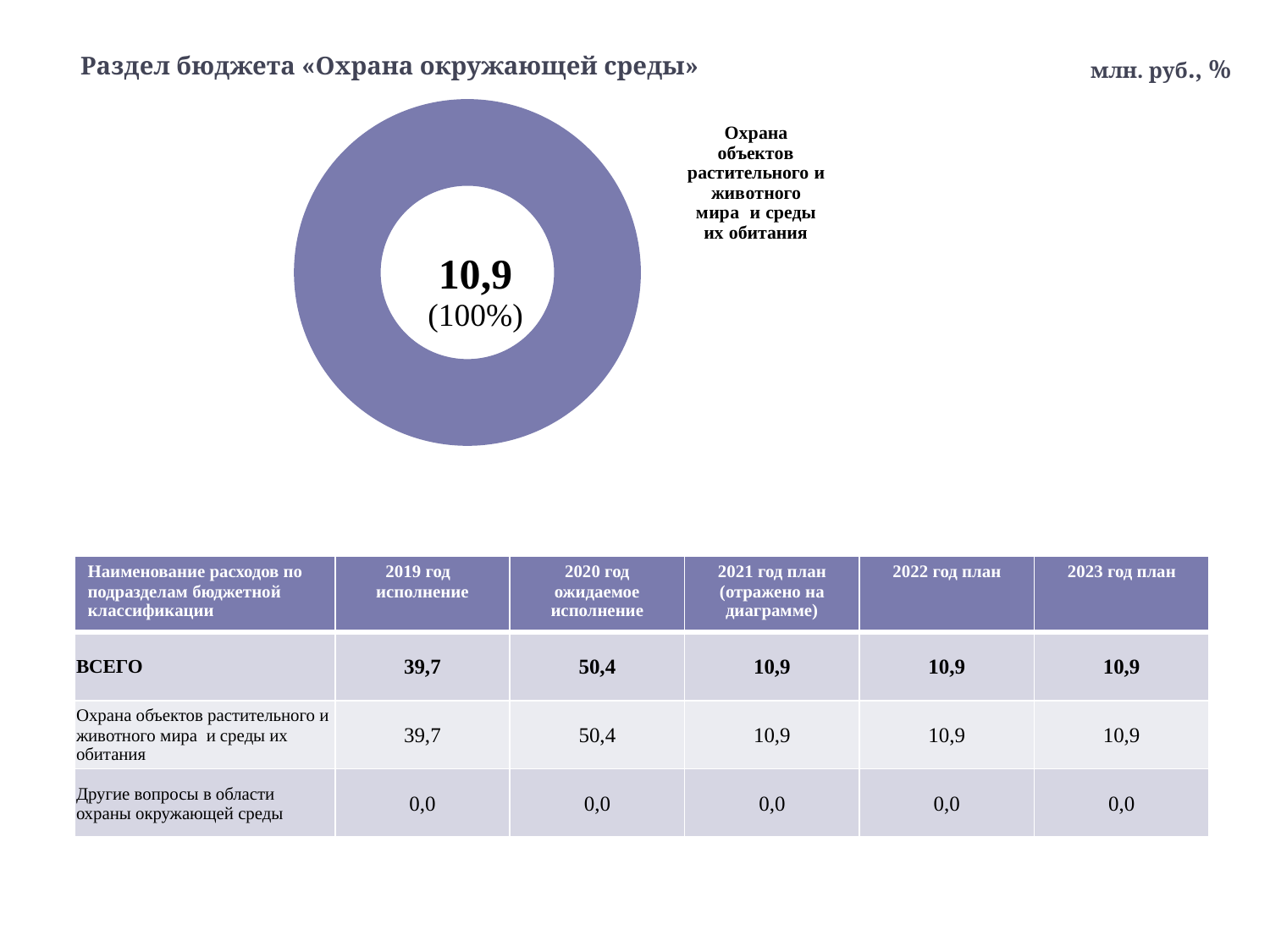
What value is printed in the centre of the donut chart? 10,9 Which year's plan does the donut chart reflect, according to the table header? 2021 год план How many slices does the donut chart contain? 1 What kind of chart is shown on the slide? Donut (pie) chart What share of the donut chart does the slice «Охрана объектов растительного и животного мира и среды их обитания» represent? 100% Is the value shown in the centre of the donut chart greater or less than 10? greater What units are indicated for the chart values in the top right corner of the slide? млн. руб., % What is the title of the slide containing the donut chart? Раздел бюджета «Охрана окружающей среды» Which category is shown in the donut chart? Охрана объектов растительного и животного мира и среды их обитания